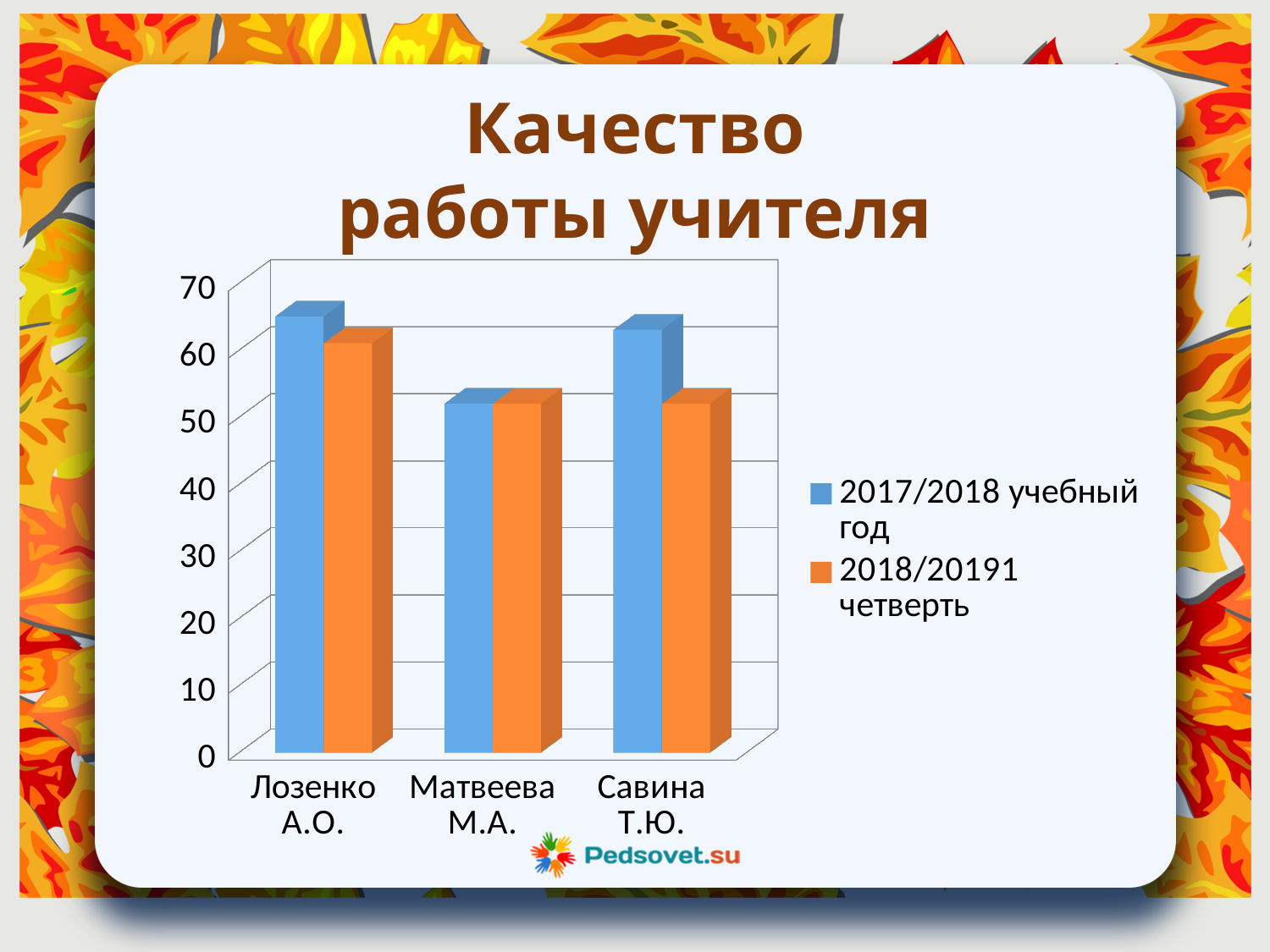
Which series is shown in orange? 2018/20191 четверть How many teachers (categories) are shown on the x axis? 3 For Савина Т.Ю., which is larger: the 2017/2018 учебный год value or the 2018/20191 четверть value? 2017/2018 учебный год Which teacher has the highest value for 2018/20191 четверть? Лозенко А.О. Is the 2017/2018 учебный год value for Матвеева М.А. greater or less than 60? less How many series does the legend list? 2 Is the 2017/2018 учебный год value for Лозенко А.О. greater or less than 60? greater Is the 2018/20191 четверть value for Савина Т.Ю. greater or less than 60? less Which teacher has the lowest value for 2017/2018 учебный год? Матвеева М.А. What kind of chart is shown on the slide? bar chart What is the title of the chart? Качество работы учителя For Лозенко А.О., which is larger: the 2017/2018 учебный год value or the 2018/20191 четверть value? 2017/2018 учебный год